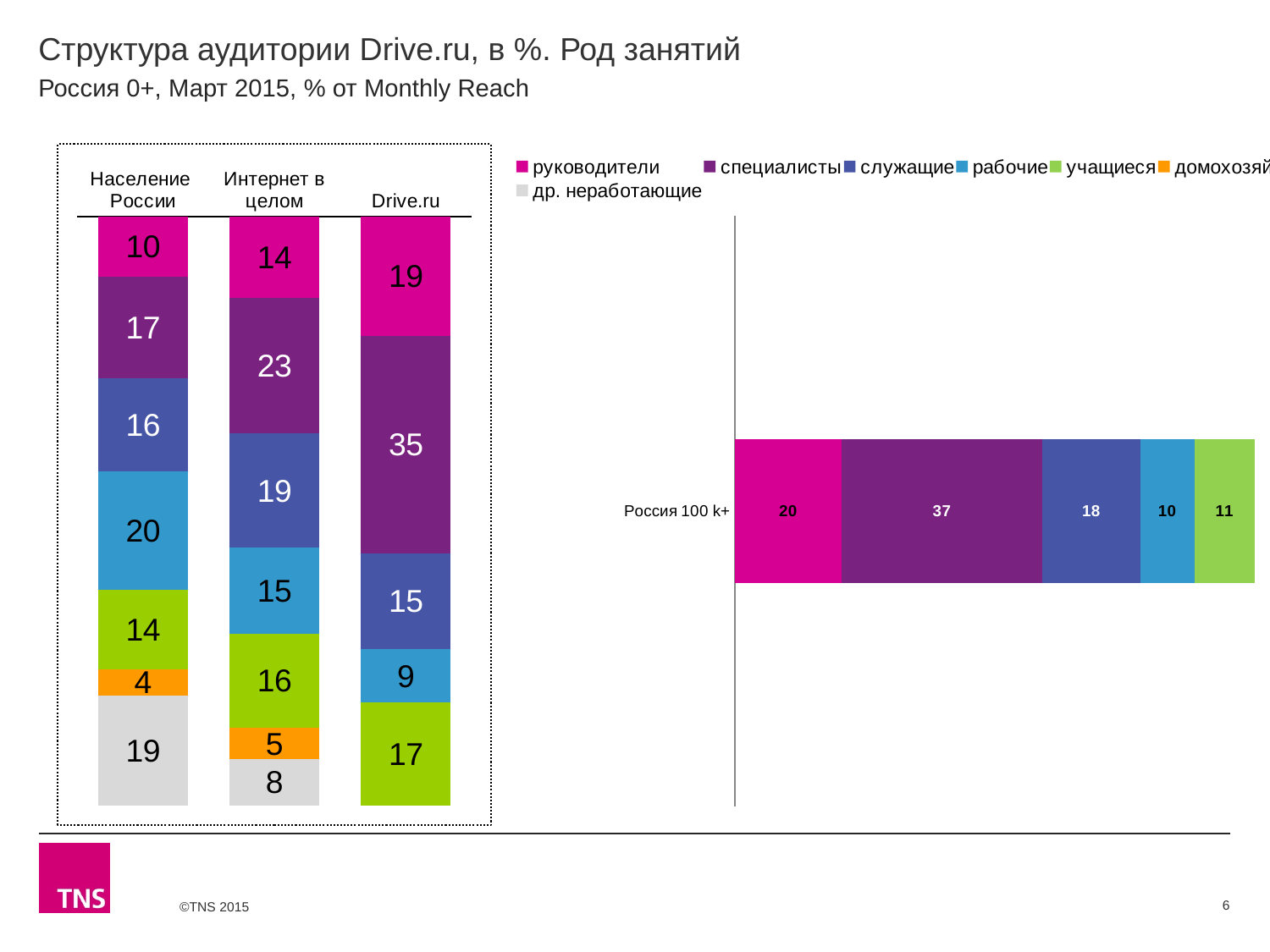
How many series does the legend list? 7 In the left stacked bar chart, which has the larger руководители value: Drive.ru or Население России? Drive.ru In the right chart (Россия 100 k+), what is the value of the специалисты segment? 37 How many bars are shown in the left stacked bar chart? 3 In the right chart (Россия 100 k+), which segment has the highest value? специалисты In the right chart, what is the total of the Россия 100 k+ bar? 96 In the left stacked bar chart, what is the value of the специалисты segment for Drive.ru? 35 In the left stacked bar chart, what is the total of the Drive.ru bar? 95 In the left stacked bar chart, what is the difference between the специалисты value for Drive.ru and for Интернет в целом? 12 In the left stacked bar chart, what is the value of the рабочие segment for Население России? 20 What kind of chart is the right chart (Россия 100 k+)? Stacked bar chart In the right chart (Россия 100 k+), which segment has the lowest value? рабочие